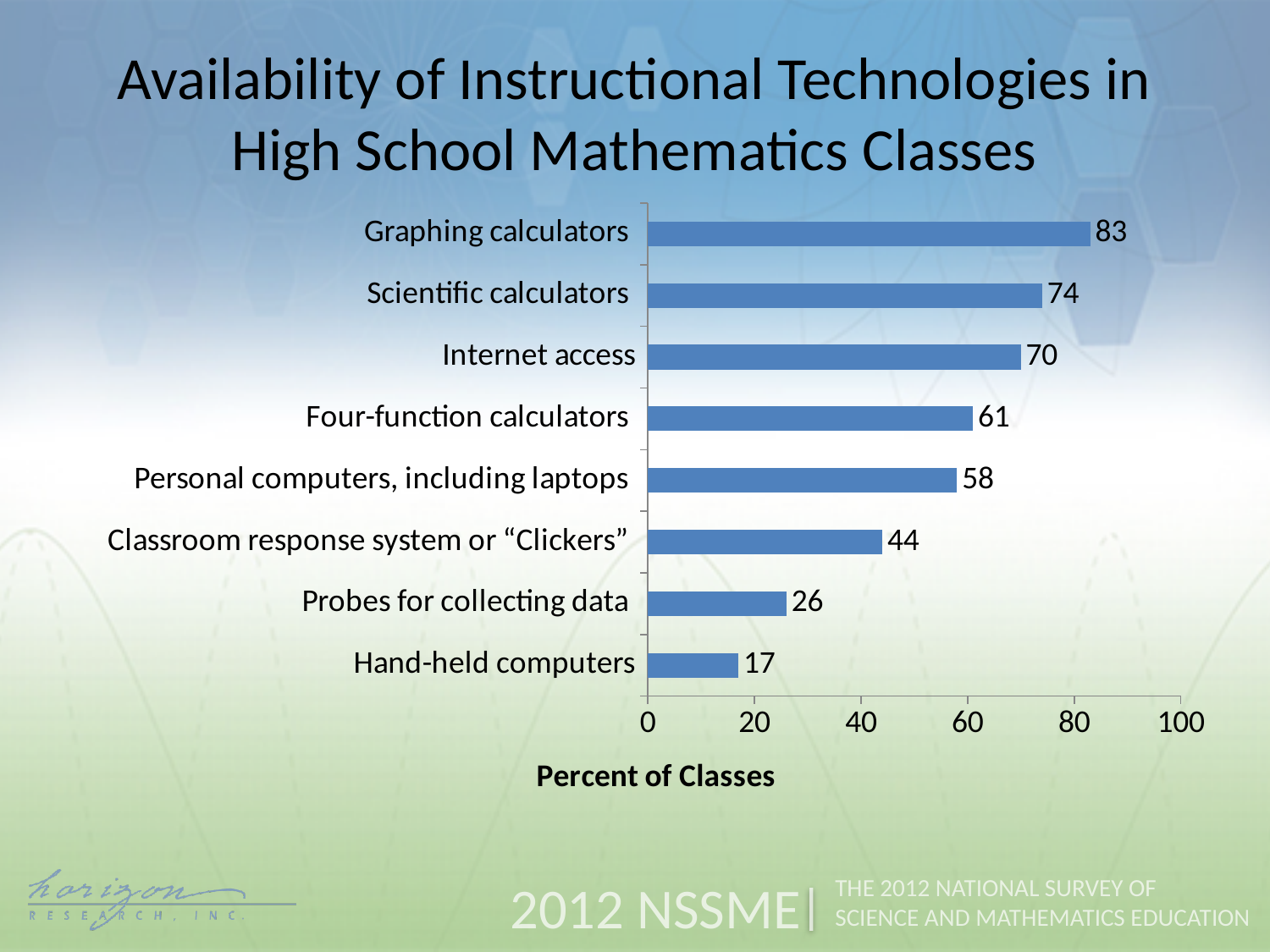
What is the difference between the values for Graphing calculators and Hand-held computers? 66 Which technology has the lowest availability? Hand-held computers Is the value for Internet access greater or less than 60? greater How many technology categories are shown in the chart? 8 What is the value for Probes for collecting data? 26 What is the label of the horizontal axis? Percent of Classes What is the value for Personal computers, including laptops? 58 What is the difference between the values for Scientific calculators and Internet access? 4 What percent of classes have graphing calculators available? 83 What kind of chart is shown on the slide? Bar chart Which technology has the highest availability? Graphing calculators Which is larger: the value for Four-function calculators or the value for Classroom response system or "Clickers"? Four-function calculators